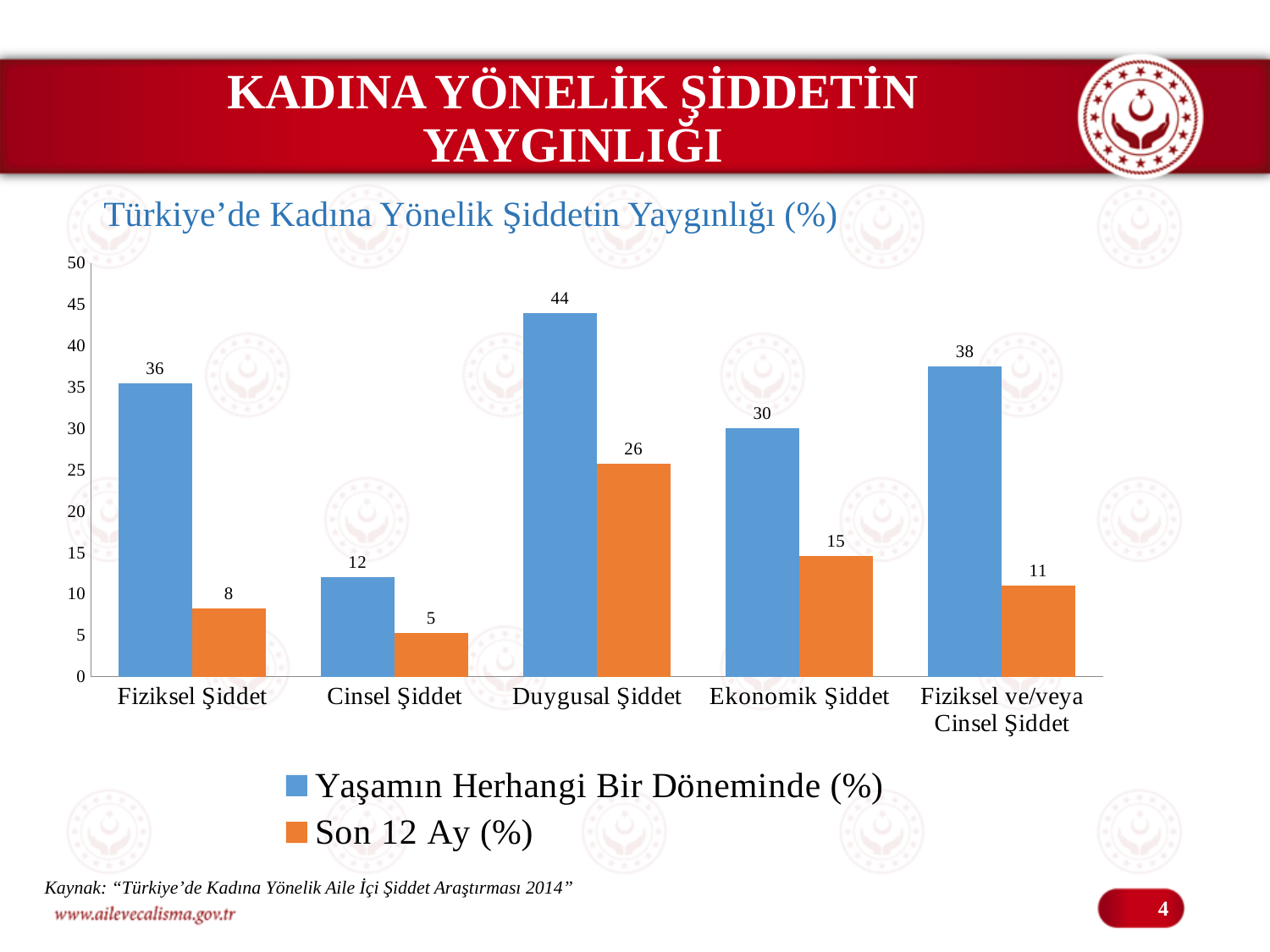
What is the value for Duygusal Şiddet in the Yaşamın Herhangi Bir Döneminde (%) series? 44 What is the value for Cinsel Şiddet in the Son 12 Ay (%) series? 5 Which category has the highest value in the Son 12 Ay (%) series? Duygusal Şiddet How many series does the legend list? 2 What kind of chart is shown on the slide? bar chart Which is larger: the Son 12 Ay (%) value for Ekonomik Şiddet or for Fiziksel ve/veya Cinsel Şiddet? Ekonomik Şiddet Which category has the lowest value in the Yaşamın Herhangi Bir Döneminde (%) series? Cinsel Şiddet Is the Yaşamın Herhangi Bir Döneminde (%) value for Ekonomik Şiddet greater or less than 25? greater How many categories are shown on the x axis? 5 What is the difference between the Yaşamın Herhangi Bir Döneminde (%) and Son 12 Ay (%) values for Fiziksel Şiddet? 28 What is the title of the chart? Türkiye'de Kadına Yönelik Şiddetin Yaygınlığı (%) What is the value for Fiziksel ve/veya Cinsel Şiddet in the Yaşamın Herhangi Bir Döneminde (%) series? 38